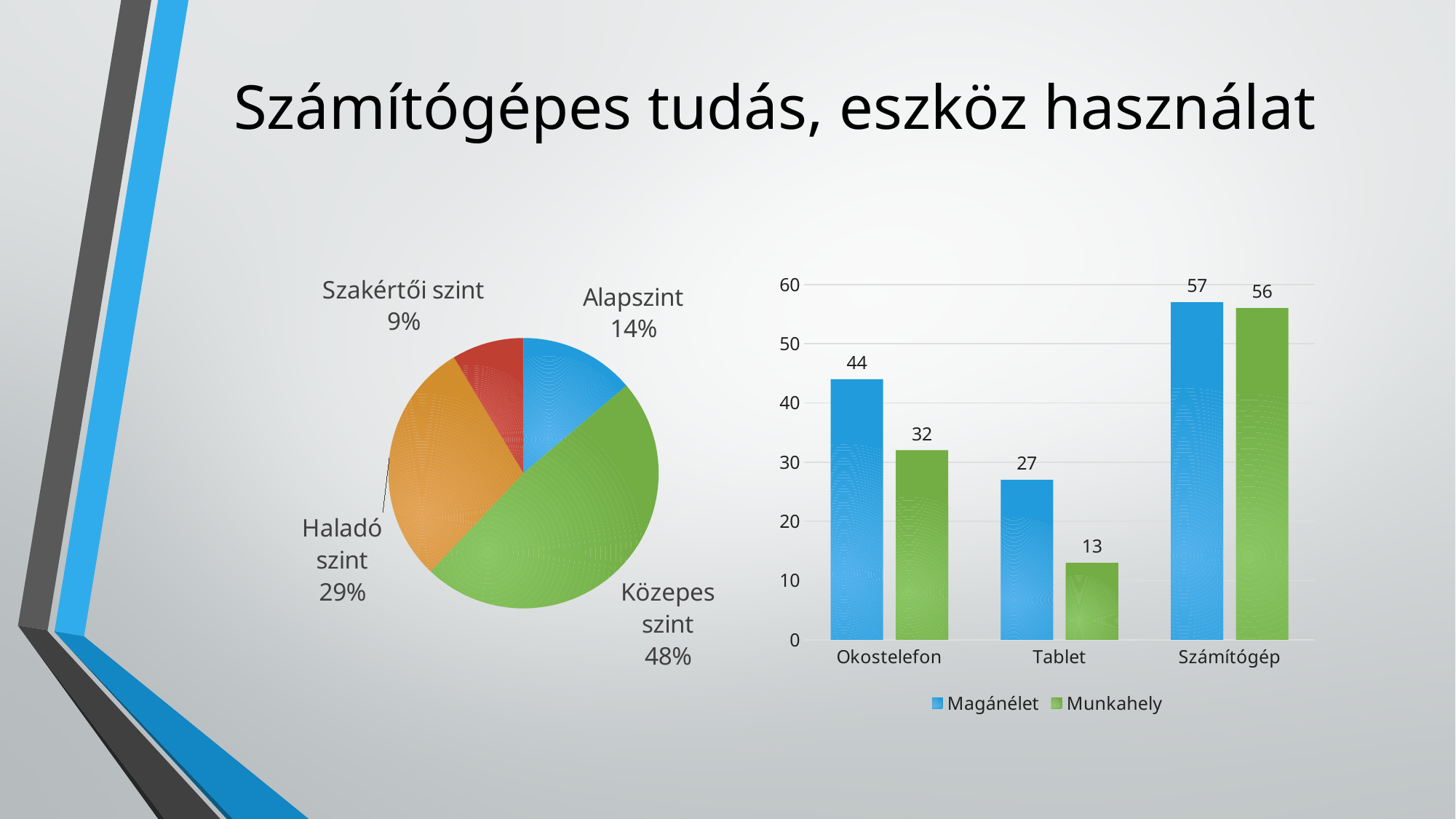
In the pie chart on the left, how many slices are there? 4 In the bar chart on the right, what is the Munkahely value for Tablet? 13 In the pie chart on the left, which category has the largest slice? Közepes szint In the bar chart on the right, what is the difference between the Magánélet and Munkahely values for Okostelefon? 12 In the pie chart on the left, what is the difference in percentage points between Haladó szint and Alapszint? 15 What type of chart is shown on the right side of the slide? Bar chart In the pie chart on the left, what share does Szakértői szint have? 9% In the bar chart on the right, which category has the highest Munkahely value? Számítógép In the pie chart on the left, what share does Közepes szint have? 48% In the pie chart on the left, which category has the smallest slice? Szakértői szint In the bar chart on the right, what is the Magánélet value for Okostelefon? 44 In the bar chart on the right, how many series does the legend list? 2